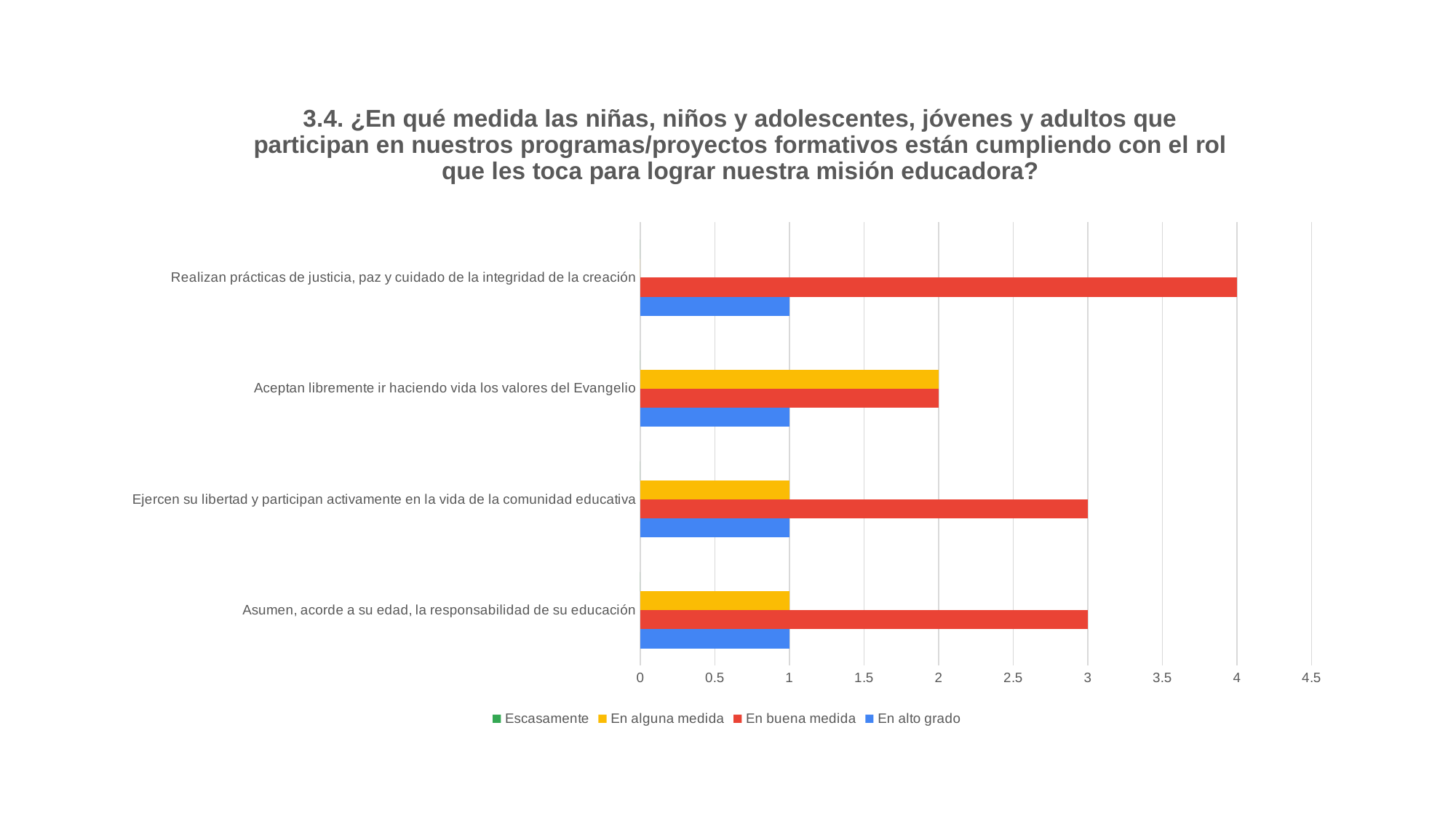
Which category has the highest value for 'En buena medida'? Realizan prácticas de justicia, paz y cuidado de la integridad de la creación What is the difference between 'En buena medida' and 'En alto grado' for 'Realizan prácticas de justicia, paz y cuidado de la integridad de la creación'? 3 What is the value of 'En buena medida' for 'Ejercen su libertad y participan activamente en la vida de la comunidad educativa'? 3 What is the value of 'En buena medida' for 'Realizan prácticas de justicia, paz y cuidado de la integridad de la creación'? 4 How many categories are plotted on the chart? 4 What is the value of 'En alguna medida' for 'Aceptan libremente ir haciendo vida los valores del Evangelio'? 2 Which legend entry is shown in red? En buena medida For 'Ejercen su libertad y participan activamente en la vida de la comunidad educativa', which is larger: 'En buena medida' or 'En alguna medida'? En buena medida What is the value of 'En alto grado' for 'Asumen, acorde a su edad, la responsabilidad de su educación'? 1 Which category has the lowest value for 'En buena medida'? Aceptan libremente ir haciendo vida los valores del Evangelio What kind of chart is shown on the slide? bar chart How many series does the legend list? 4